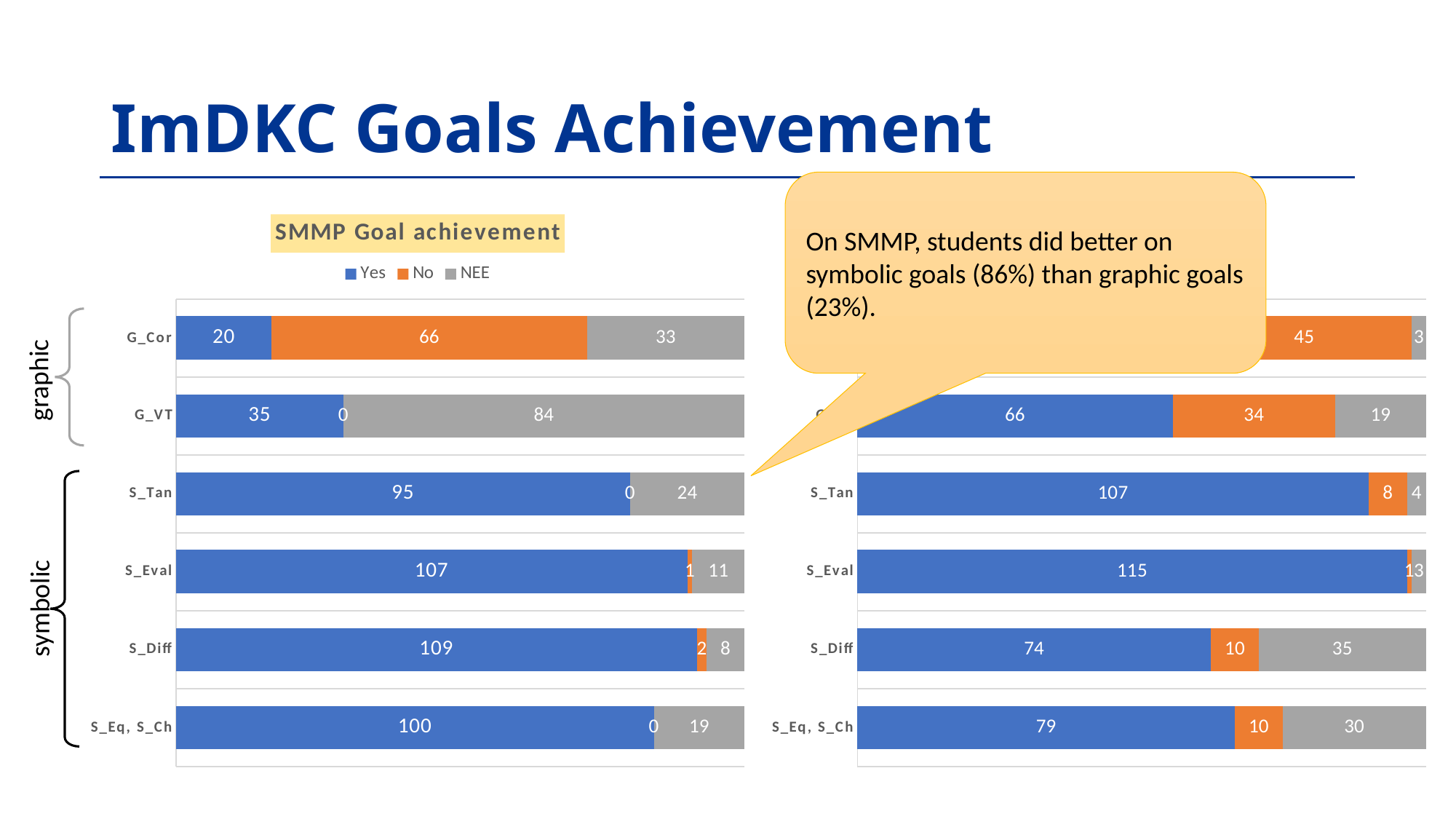
In the SMMP Goal achievement chart, what is the total of the S_Tan bar (Yes + No + NEE)? 119 In the SMMP Goal achievement chart, how many categories are plotted? 6 In the SMMP Goal achievement chart, what is the No value for G_Cor? 66 In the right-hand chart, what is the NEE value for S_Diff? 35 In the SMMP Goal achievement chart, what is the Yes value for S_Diff? 109 In the SMMP Goal achievement chart, what is the difference between the Yes values for S_Eval and G_VT? 72 In the SMMP Goal achievement chart, how many series does the legend list? 3 In the SMMP Goal achievement chart, which category has the highest Yes value? S_Diff In the SMMP Goal achievement chart, which category has the lowest Yes value? G_Cor In the right-hand chart, which is larger, the Yes value for S_Tan or the Yes value for S_Eq, S_Ch? S_Tan In the SMMP Goal achievement chart, what is the NEE value for G_VT? 84 What kind of chart is the SMMP Goal achievement chart? Stacked bar chart